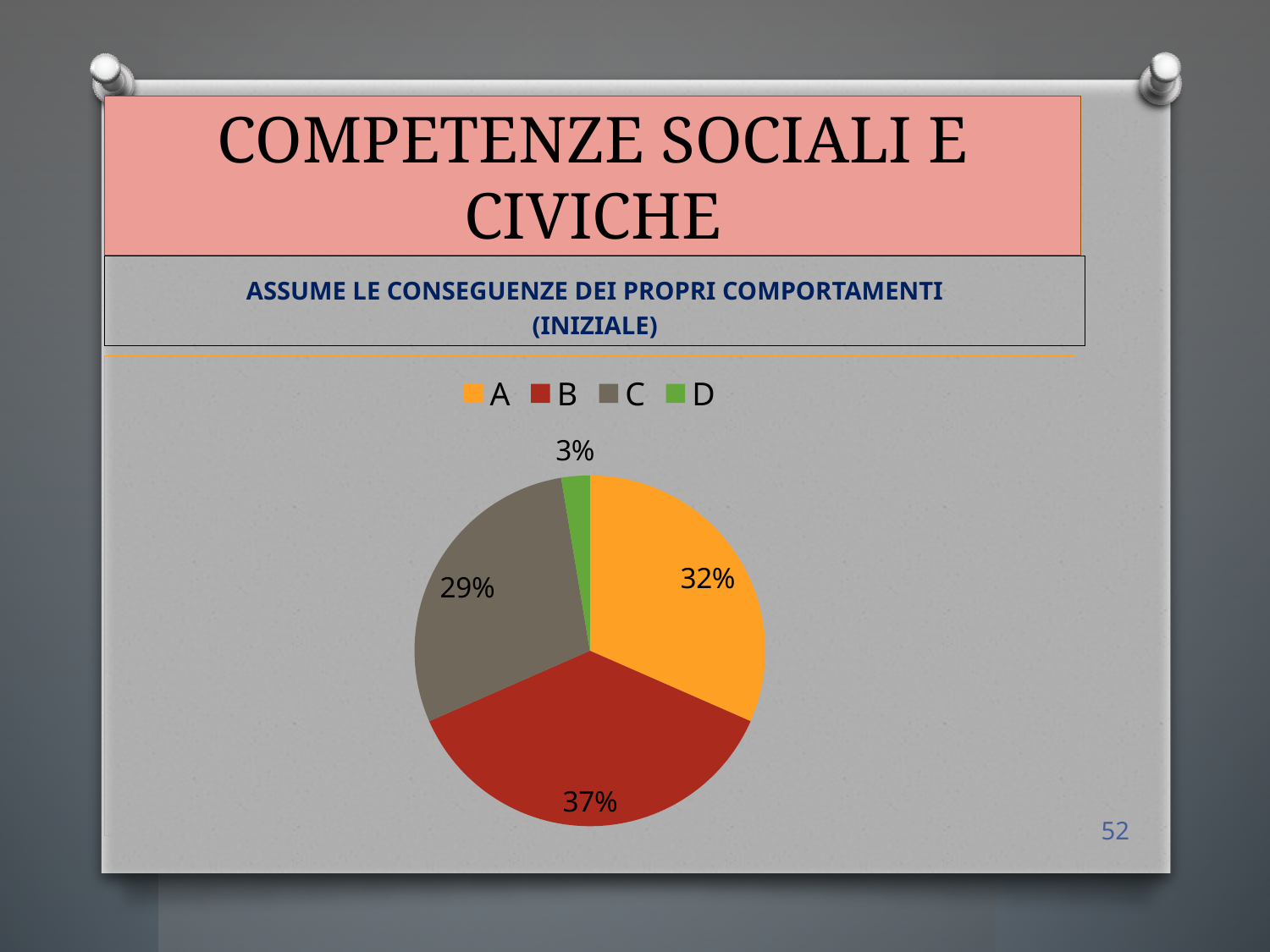
How many entries does the legend list? 4 What is the difference in percentage points between category B and category C? 8 What kind of chart is shown on the slide? pie chart How many slices does the pie chart have? 4 What colour is the slice for category D? green What is the share for category B? 37% Which category has the smallest slice of the pie? D What is the share for category C? 29% Which category has the largest slice of the pie? B Which is larger, the share for A or the share for C? A What is the share for category A? 32% What is the share for category D? 3%